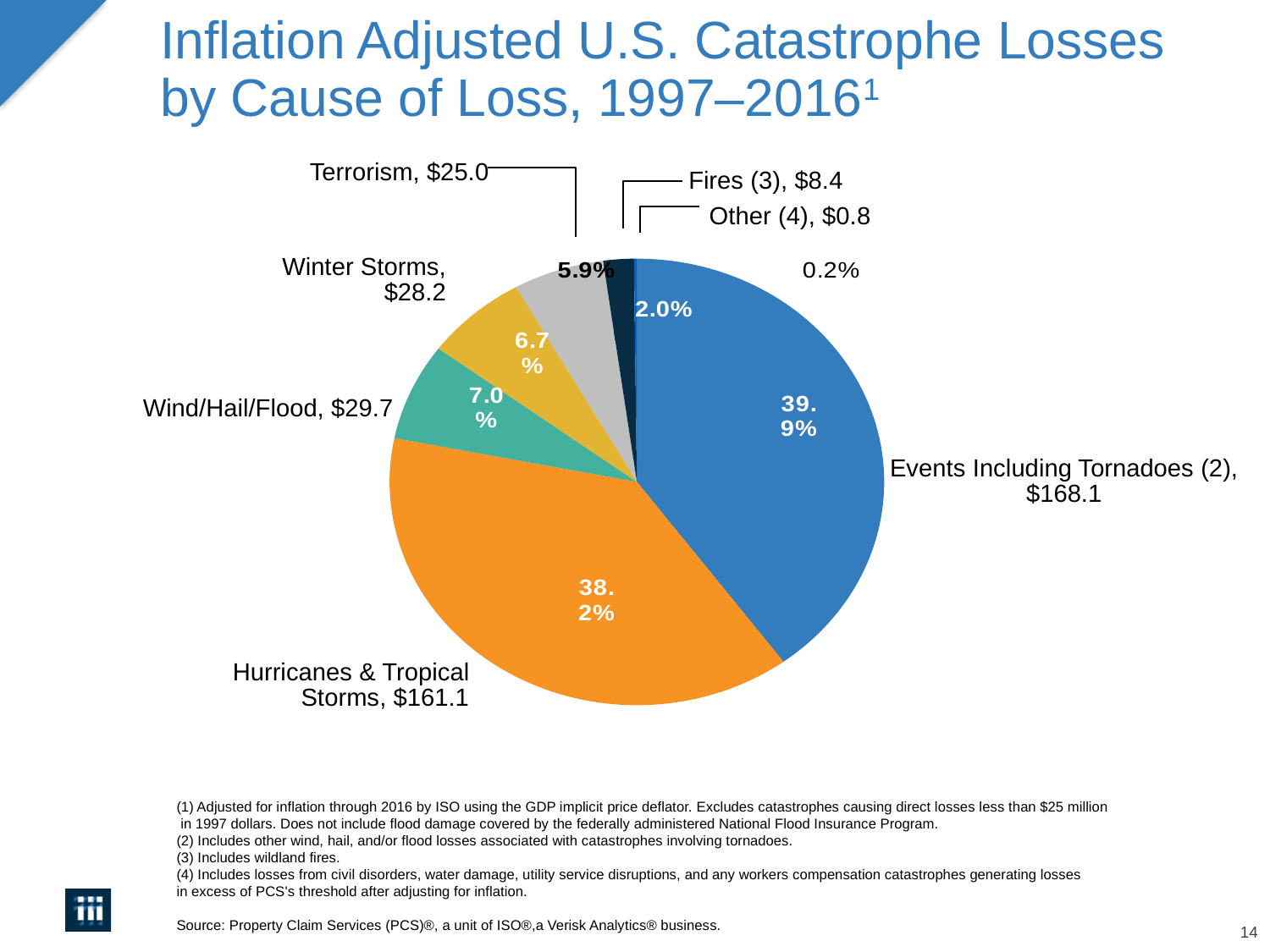
Which is larger, the value for Wind/Hail/Flood or the value for Winter Storms? Wind/Hail/Flood Which cause of loss has the smallest slice of the pie? Other (4) What is the value shown for Events Including Tornadoes (2)? $168.1 How many causes of loss are shown in the pie chart? 7 What share of the pie does Hurricanes & Tropical Storms represent? 38.2% What kind of chart is shown on the slide? Pie chart What is the value shown for Terrorism? $25.0 What share of the pie does Winter Storms represent? 6.7% What is the value shown for Hurricanes & Tropical Storms? $161.1 Which cause of loss has the largest slice of the pie? Events Including Tornadoes (2) What is the value shown for Fires (3)? $8.4 What is the difference between the values for Events Including Tornadoes (2) and Hurricanes & Tropical Storms? $7.0